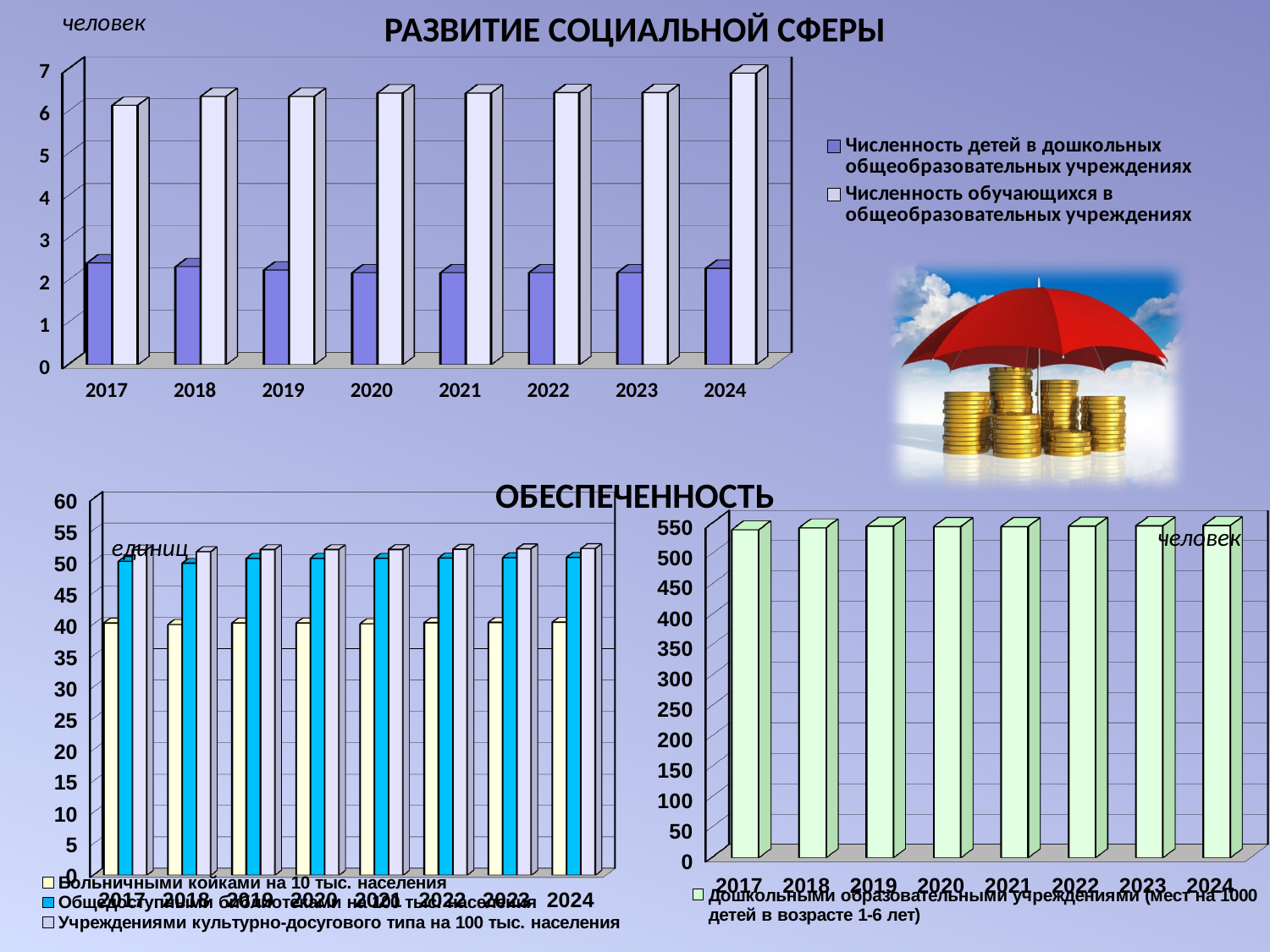
In the top chart 'РАЗВИТИЕ СОЦИАЛЬНОЙ СФЕРЫ', how many series does the legend list? 2 In the top chart 'РАЗВИТИЕ СОЦИАЛЬНОЙ СФЕРЫ', is the 2017 value for 'Численность обучающихся в общеобразовательных учреждениях' greater or less than 5? greater In the bottom-right chart, is the 2017 value for 'Дошкольными образовательными учреждениями (мест на 1000 детей в возрасте 1-6 лет)' greater or less than 500? greater What type of chart is the top chart titled 'РАЗВИТИЕ СОЦИАЛЬНОЙ СФЕРЫ'? Bar chart In the top chart 'РАЗВИТИЕ СОЦИАЛЬНОЙ СФЕРЫ', is the 2017 value for 'Численность детей в дошкольных общеобразовательных учреждениях' greater or less than 3? less In the bottom-left chart 'ОБЕСПЕЧЕННОСТЬ', which is larger in 2020: 'Общедоступными библиотеками на 100 тыс. населения' or 'Больничными койками на 10 тыс. населения'? Общедоступными библиотеками на 100 тыс. населения In the top chart 'РАЗВИТИЕ СОЦИАЛЬНОЙ СФЕРЫ', which year has the highest value for 'Численность обучающихся в общеобразовательных учреждениях'? 2024 In the bottom-left chart 'ОБЕСПЕЧЕННОСТЬ', how many series does the legend list? 3 In the bottom-right chart, how many years are shown on the x axis? 8 In the top chart 'РАЗВИТИЕ СОЦИАЛЬНОЙ СФЕРЫ', how many years are shown on the x axis? 8 In the top chart 'РАЗВИТИЕ СОЦИАЛЬНОЙ СФЕРЫ', which series has the larger value in 2020? Численность обучающихся в общеобразовательных учреждениях